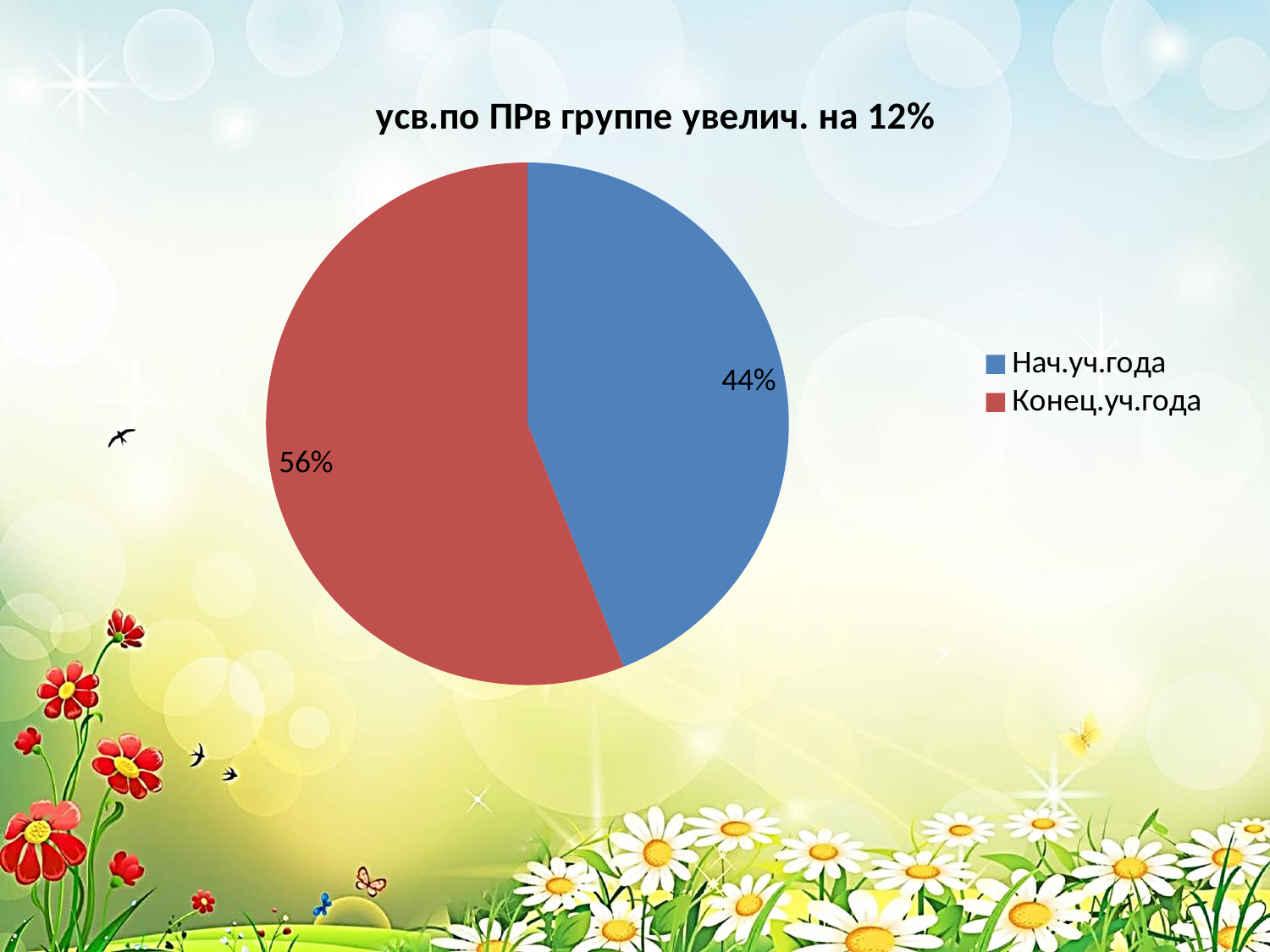
What is the difference between the values for Конец.уч.года and Нач.уч.года? 12% What is the title of the chart? усв.по ПРв группе увелич. на 12% What colour is the slice for Нач.уч.года? blue How many slices does the pie chart have? 2 How many entries does the legend list? 2 Which slice is the largest? Конец.уч.года What kind of chart is shown on the slide? pie chart Which is larger, Нач.уч.года or Конец.уч.года? Конец.уч.года What is the value for Нач.уч.года? 44% What is the value for Конец.уч.года? 56% Is the value for Конец.уч.года greater or less than 50%? greater Which slice is the smallest? Нач.уч.года